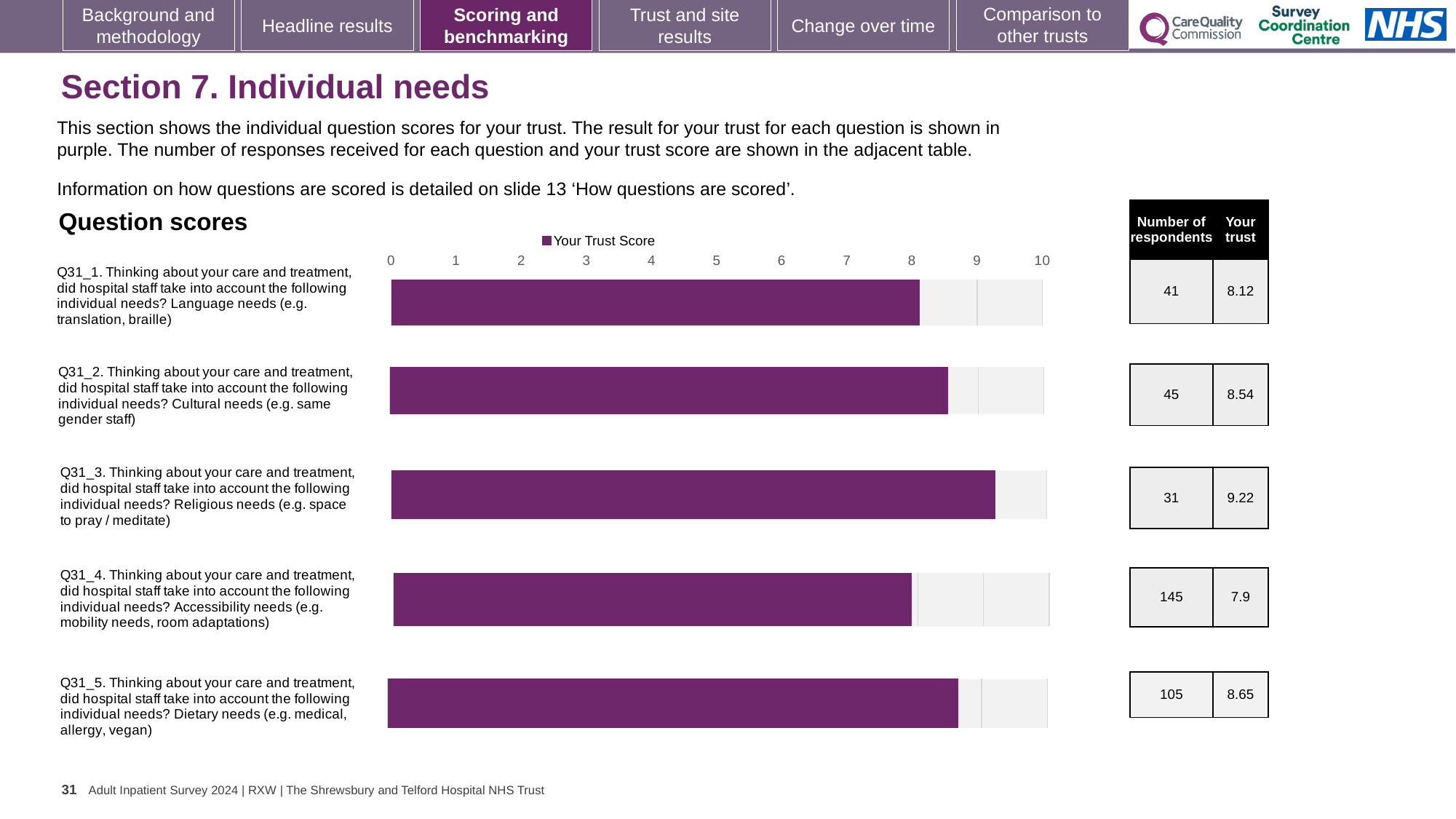
What is the name of the series shown in the legend? Your Trust Score What is the trust score for Q31_3 (Religious needs)? 9.22 Which question has the lowest trust score? Q31_4 (Accessibility needs) What is the trust score for Q31_1 (Language needs)? 8.12 How many questions are plotted in the chart? 5 Is the trust score for Q31_4 (Accessibility needs) greater or less than 8? less How many series does the legend list? 1 What is the trust score for Q31_4 (Accessibility needs)? 7.9 Which question has the highest trust score? Q31_3 (Religious needs) Which has a higher trust score, Q31_2 (Cultural needs) or Q31_5 (Dietary needs)? Q31_5 (Dietary needs) What is the difference between the trust scores for Q31_3 and Q31_4? 1.32 What kind of chart is shown? Bar chart